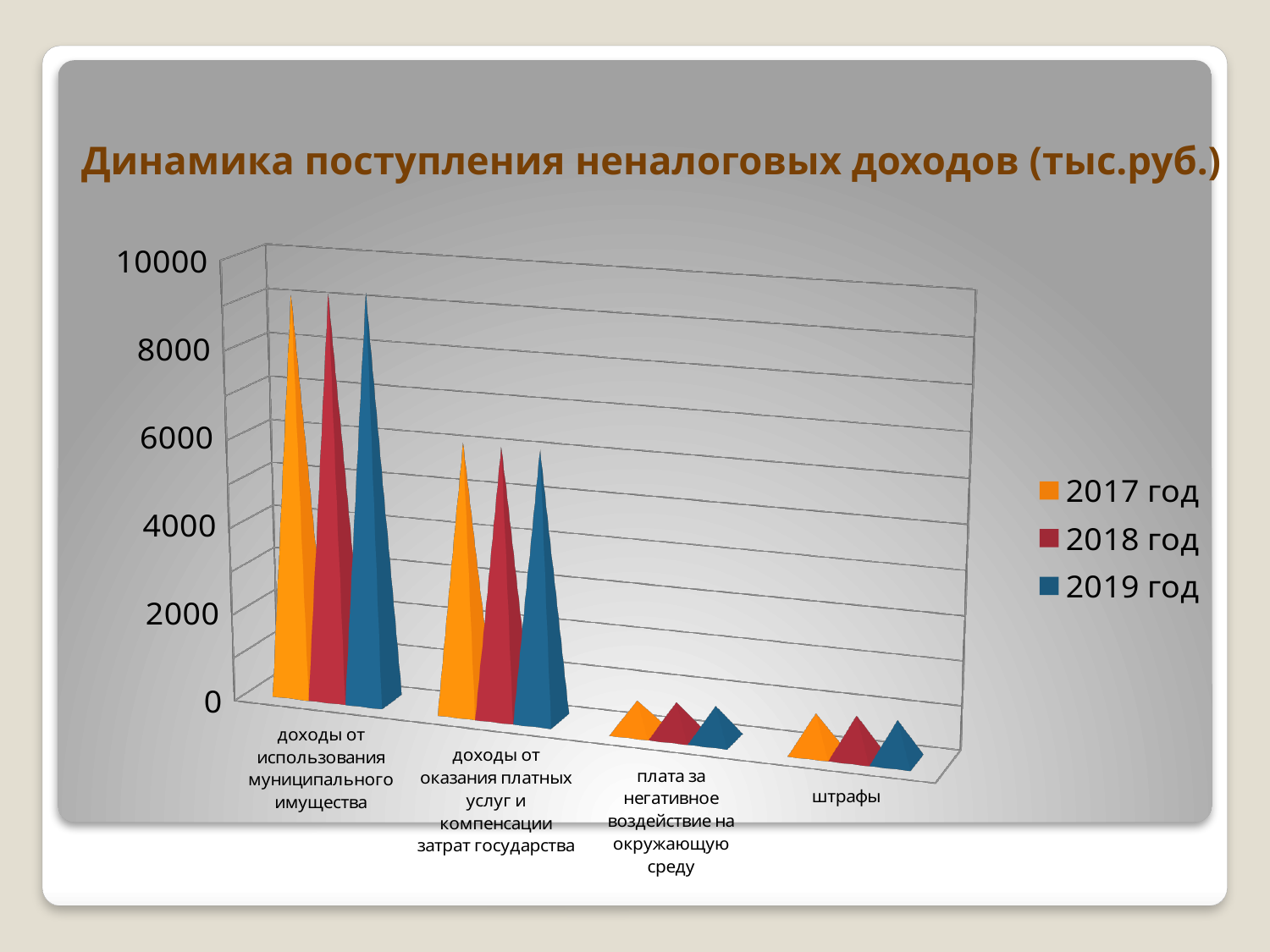
For 2019 год, which is larger: доходы от оказания платных услуг и компенсации затрат государства or плата за негативное воздействие на окружающую среду? доходы от оказания платных услуг и компенсации затрат государства What kind of chart is shown on the slide? bar chart For 2017 год, which is larger: доходы от использования муниципального имущества or штрафы? доходы от использования муниципального имущества Is the 2017 год value for плата за негативное воздействие на окружающую среду greater or less than 4000? less Is the 2017 год value for доходы от использования муниципального имущества greater or less than 8000? greater Is the 2018 год value for штрафы greater or less than 2000? less How many categories are shown on the x axis? 4 Which category has the highest values across all three years? доходы от использования муниципального имущества What is the title of the chart? Динамика поступления неналоговых доходов (тыс.руб.) Which colour represents 2019 год in the legend? blue How many series does the legend list? 3